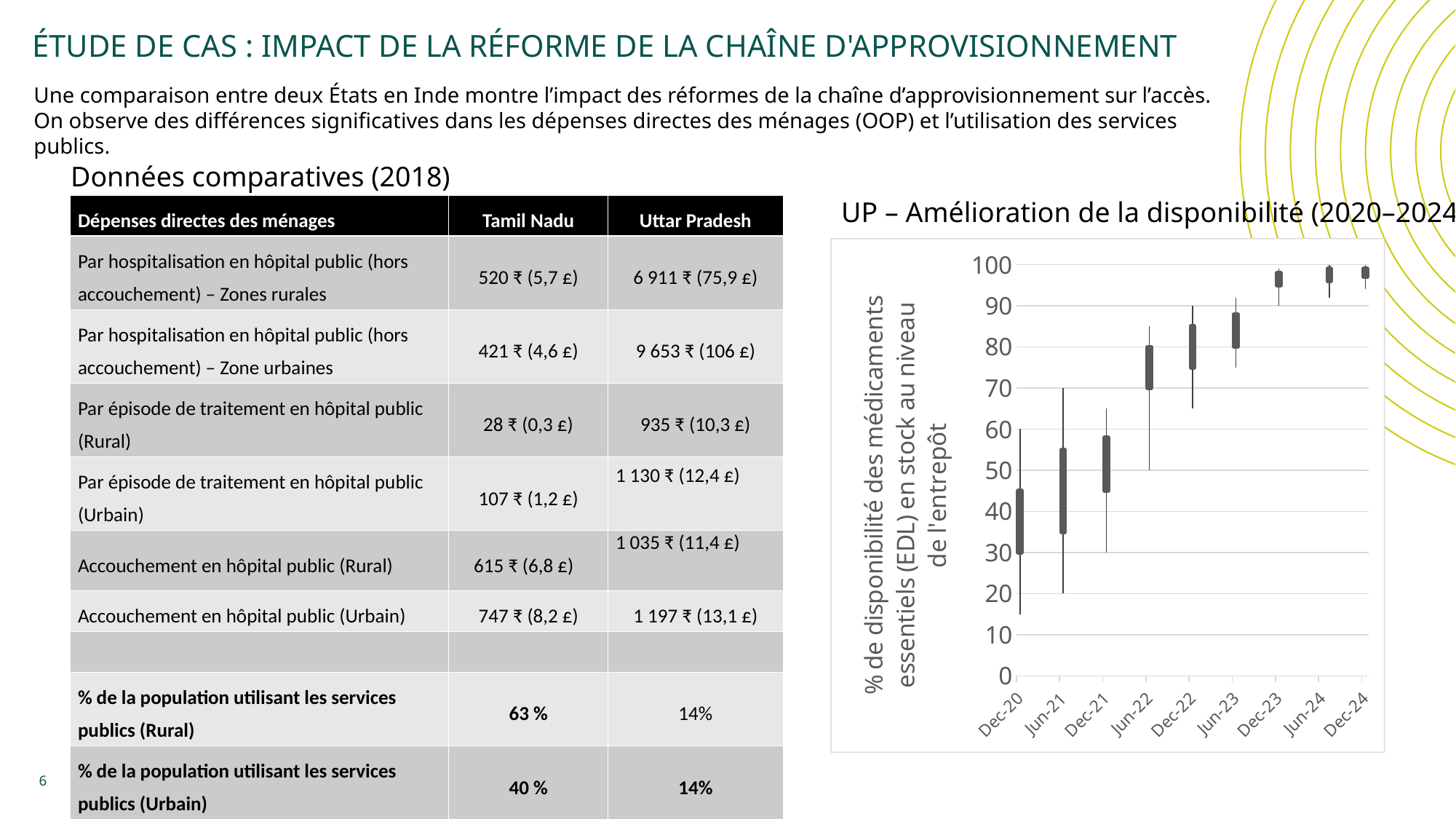
What is the last date label on the x axis of the chart? Dec-24 Is the value for Dec-20 greater or less than 70? less Is the value for Dec-24 greater or less than 90? greater Which has the larger value in the chart, Dec-20 or Dec-24? Dec-24 What kind of chart is shown under the title 'UP – Amélioration de la disponibilité'? Box-and-whisker chart Is the value for Dec-23 greater or less than 90? greater Do the values in the chart rise or fall from Dec-20 to Dec-24? Rise What is the first date label on the x axis of the chart? Dec-20 Which time point has the lowest values in the chart? Dec-20 How many time points are plotted along the x axis of the chart? 9